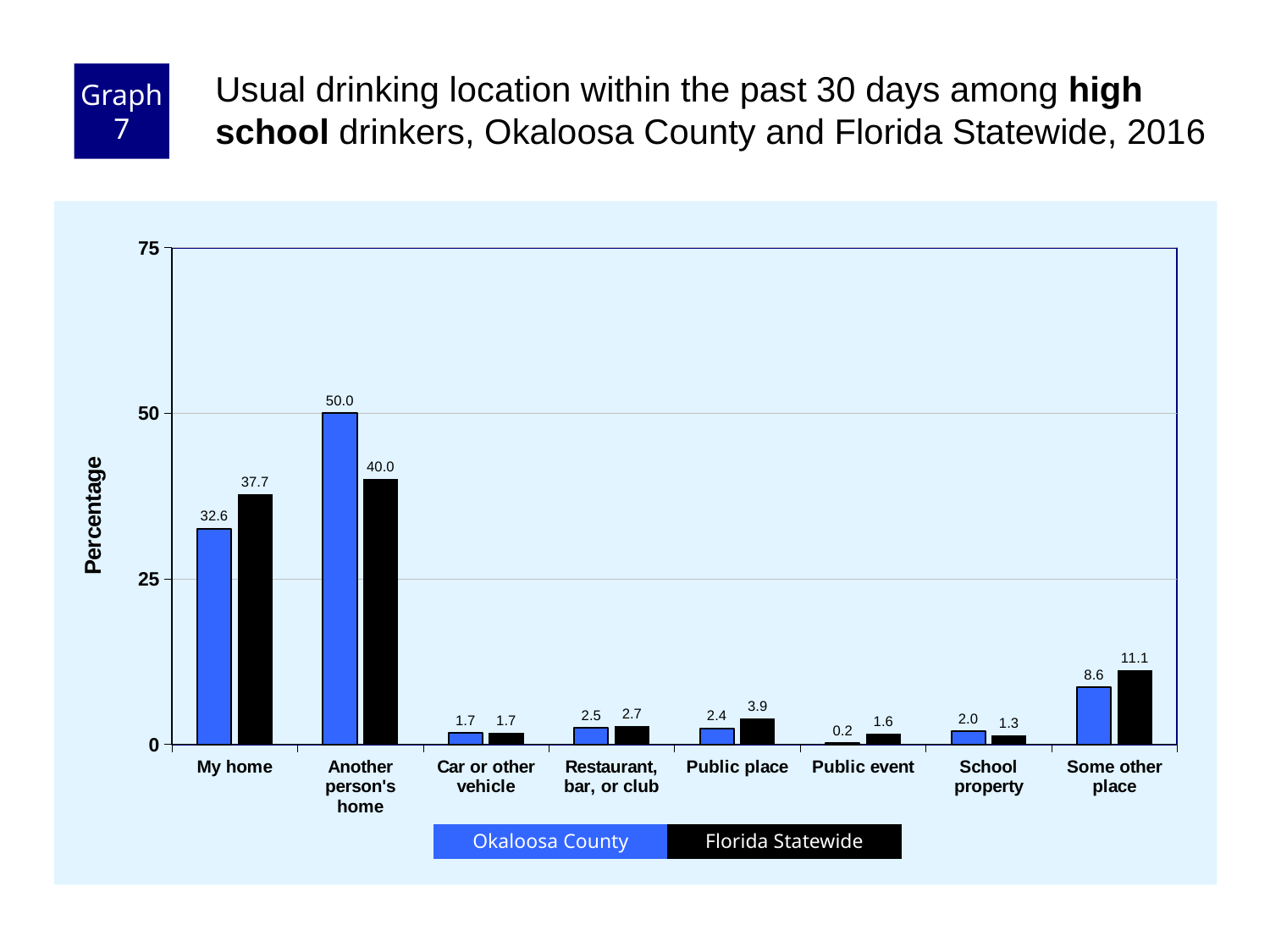
How many categories are shown on the x axis? 8 Is the Okaloosa County value for "My home" greater or less than 25? greater For "My home", which is larger: the Okaloosa County value or the Florida Statewide value? Florida Statewide Which category has the lowest Okaloosa County value? Public event Which category has the highest Okaloosa County value? Another person's home What kind of chart is shown on the slide? Bar chart What is the Okaloosa County value for "Another person's home"? 50.0 How many series does the legend list? 2 What is the difference between the Okaloosa County and Florida Statewide values for "Another person's home"? 10.0 What is the Okaloosa County value for "Public event"? 0.2 What is the difference between the Florida Statewide and Okaloosa County values for "Some other place"? 2.5 What is the Florida Statewide value for "My home"? 37.7